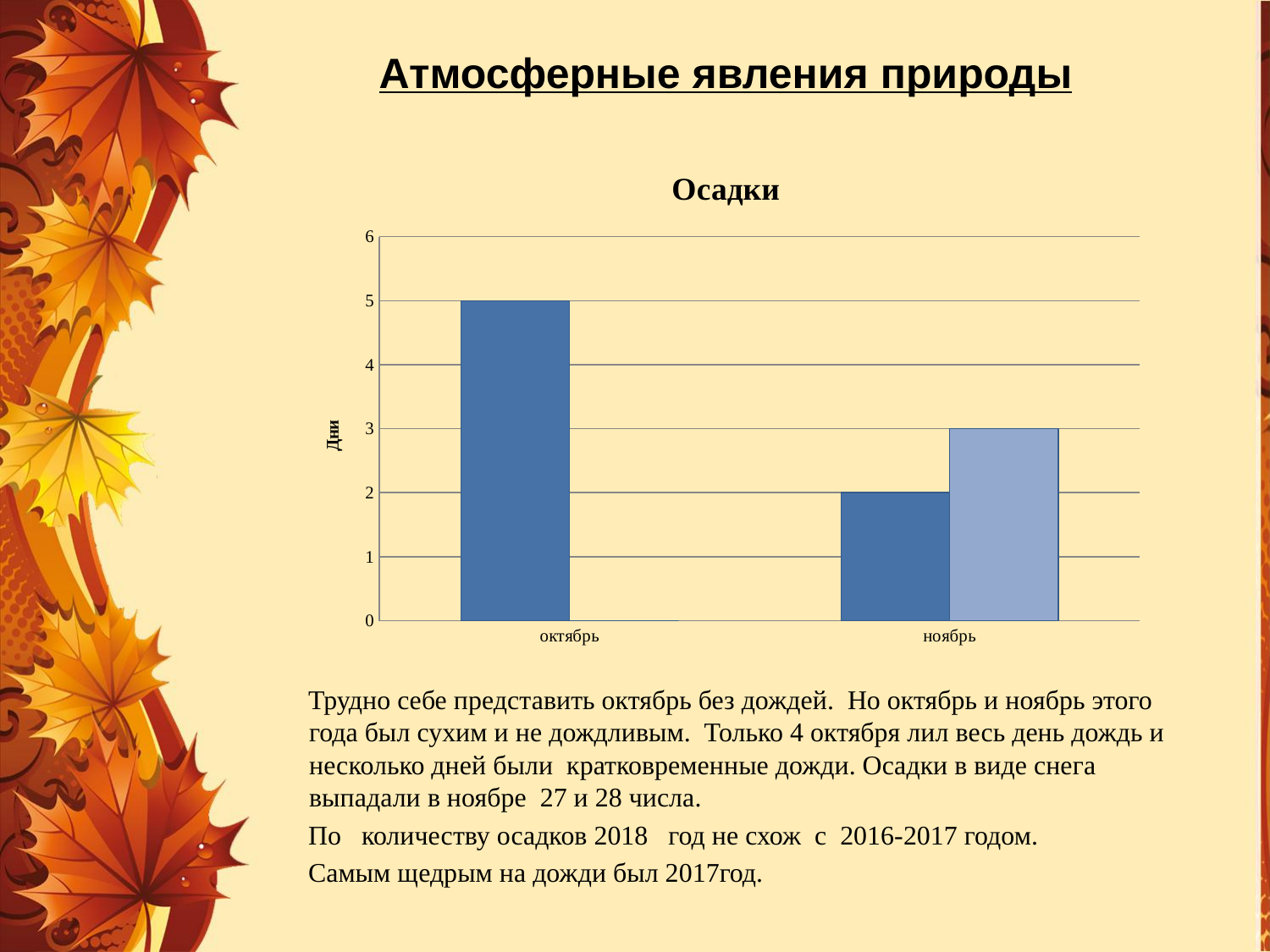
Which category has the tallest bar in the chart? октябрь What is the label of the vertical axis? Дни What is the difference between the dark blue bar for октябрь and the dark blue bar for ноябрь? 3 What type of chart is shown on the slide? bar chart What is the value of the dark blue bar for октябрь? 5 What is the maximum value shown on the vertical axis? 6 For ноябрь, which bar is taller: the dark blue bar or the light blue bar? the light blue bar What is the value of the light blue bar for ноябрь? 3 What is the value of the dark blue bar for ноябрь? 2 Is the dark blue bar for октябрь greater or less than 4? greater What is the title of the chart? Осадки How many categories are shown on the horizontal axis? 2